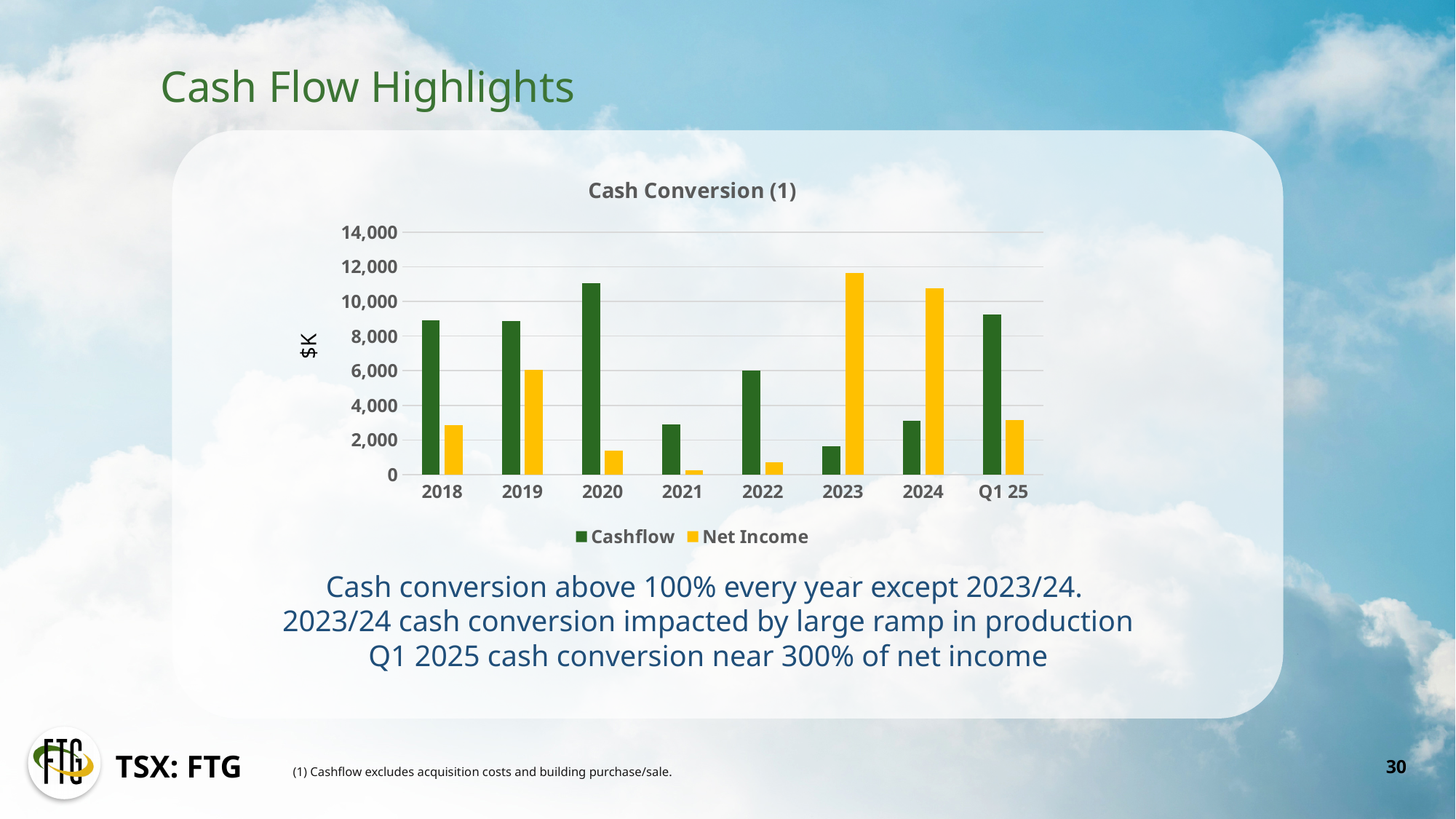
In 2023, which is larger, Cashflow or Net Income? Net Income Is the Cashflow value for 2021 greater or less than 4,000? less Is the Net Income value for 2023 greater or less than 10,000? greater How many periods are shown on the x axis? 8 How many series does the legend list? 2 Is the Net Income value for 2021 greater or less than 2,000? less In which period is Cashflow lowest? 2023 What is the label on the vertical axis? $K In which period is Cashflow highest? 2020 What kind of chart is shown on the slide? bar chart In which period is Net Income lowest? 2021